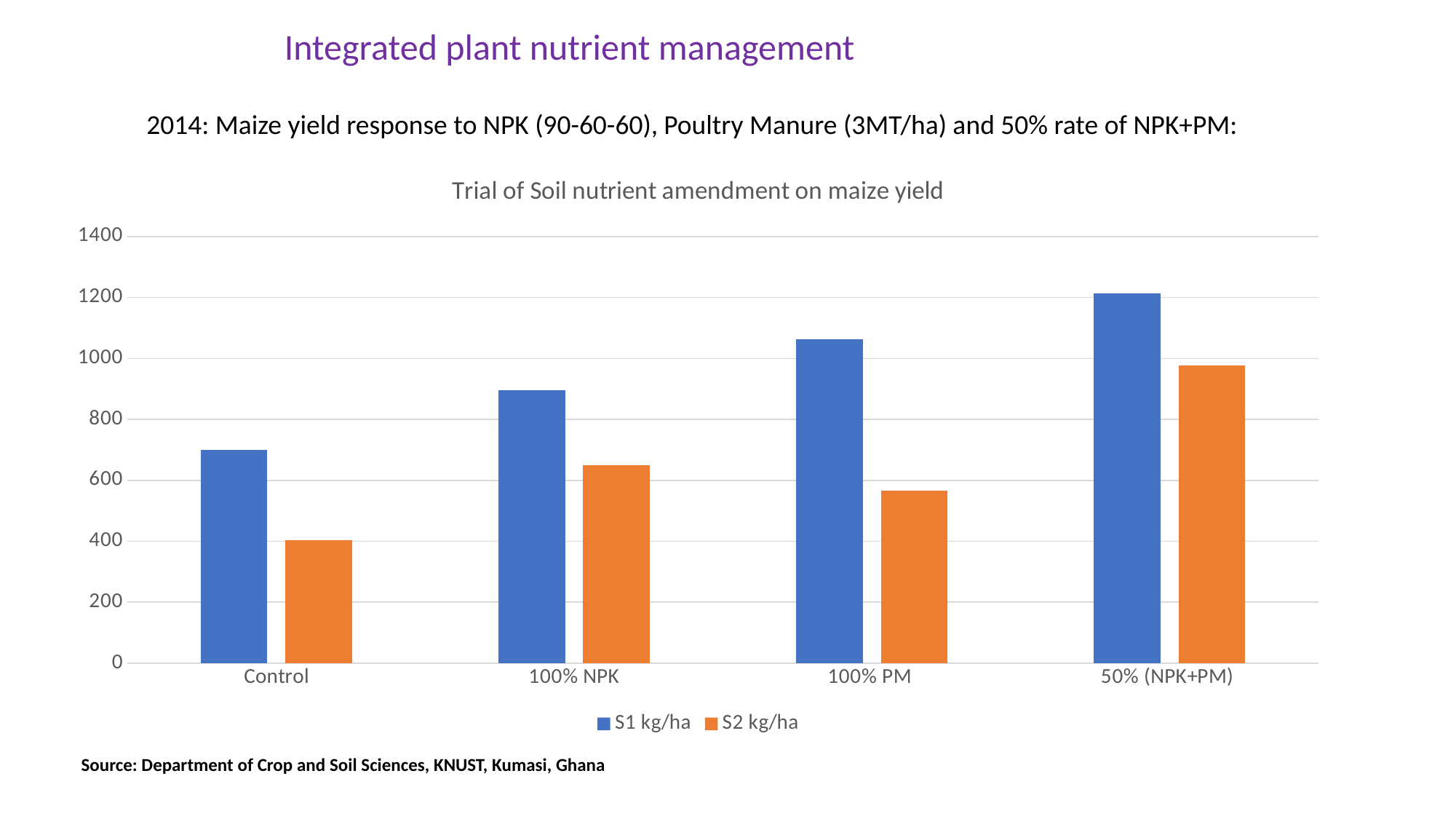
Do the S1 kg/ha values rise or fall from Control to 50% (NPK+PM) along the x axis? rise How many treatment categories are shown on the x axis? 4 Which treatment has the lowest S1 kg/ha value? Control What is the title of the chart? Trial of Soil nutrient amendment on maize yield Is the S1 kg/ha value for Control greater or less than 600? greater Which treatment has the highest S1 kg/ha value? 50% (NPK+PM) How many series does the legend list? 2 Which treatment has the lowest S2 kg/ha value? Control Which is larger, the S2 kg/ha value for 100% NPK or for 100% PM? 100% NPK Is the S2 kg/ha value for 100% PM greater or less than 600? less Is the S1 kg/ha value for 100% PM greater or less than 1000? greater What kind of chart is shown on the slide? bar chart